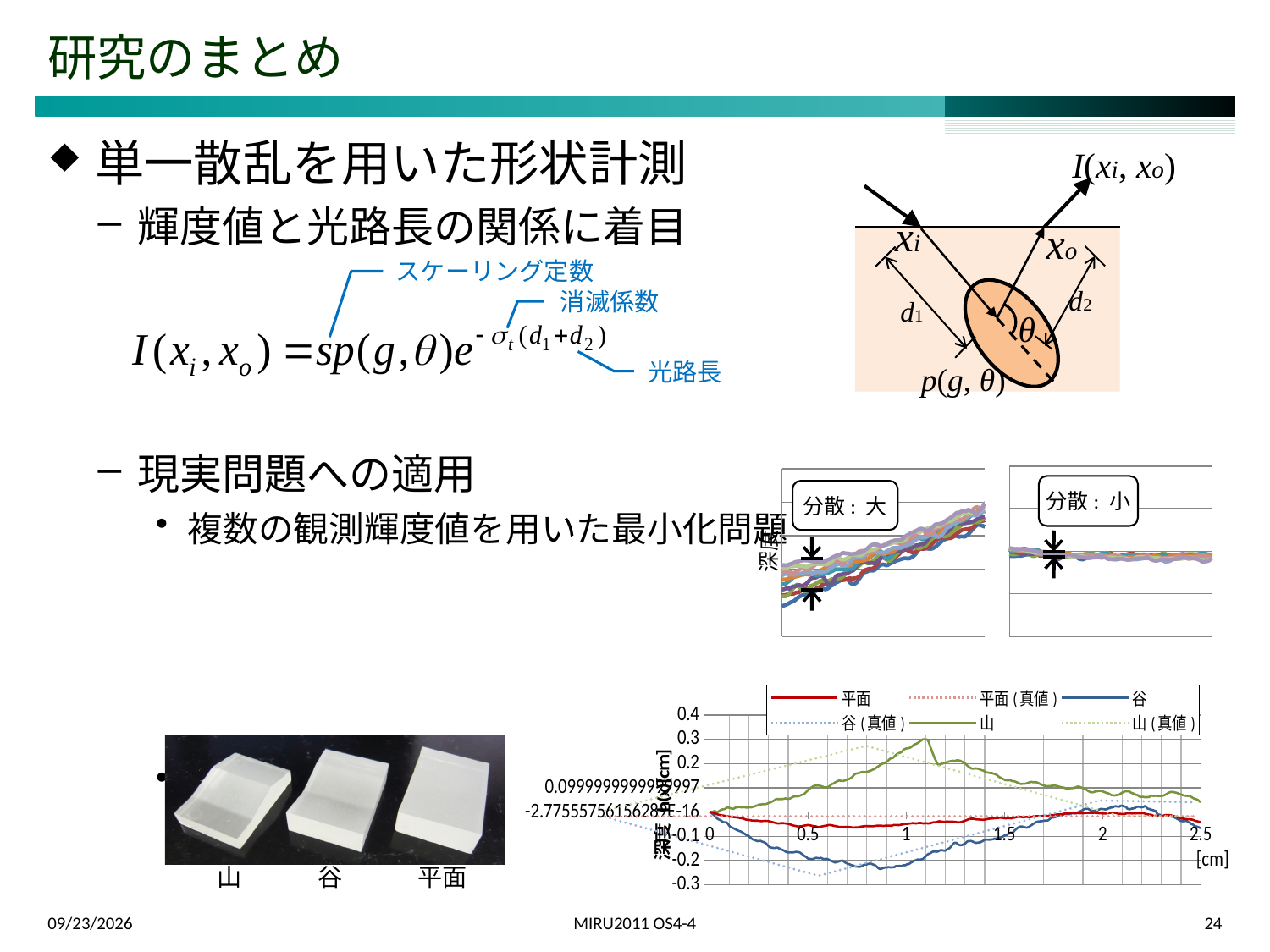
In the bottom-right line chart, which series has the highest value at x = 1? 山 In the bottom-right line chart, does the 谷 series rise or fall as x goes from 0 to 0.8? fall In the bottom-right line chart, is the value of the 谷 series at x = 1 greater or less than -0.1? less What kind of chart is the chart at the bottom right of the slide (with the legend 平面, 谷, 山)? line chart In the bottom-right line chart, is the value of the 山 series at x = 1 greater or less than 0.2? greater In the bottom-right line chart, at x = 0.5, which is larger: the value of 山 or the value of 谷? 山 How many series does the legend of the bottom-right line chart list? 6 In the bottom-right line chart, what is the unit shown on the x axis? [cm] In the bottom-right line chart, is the value of the 平面 series at x = 1.5 greater or less than 0.1? less In the bottom-right line chart, what is the largest value shown on the x axis? 2.5 In the bottom-right line chart, which series has the lowest value at x = 1? 谷 In the bottom-right line chart, does the 山 series rise or fall as x goes from 0 to 1? rise